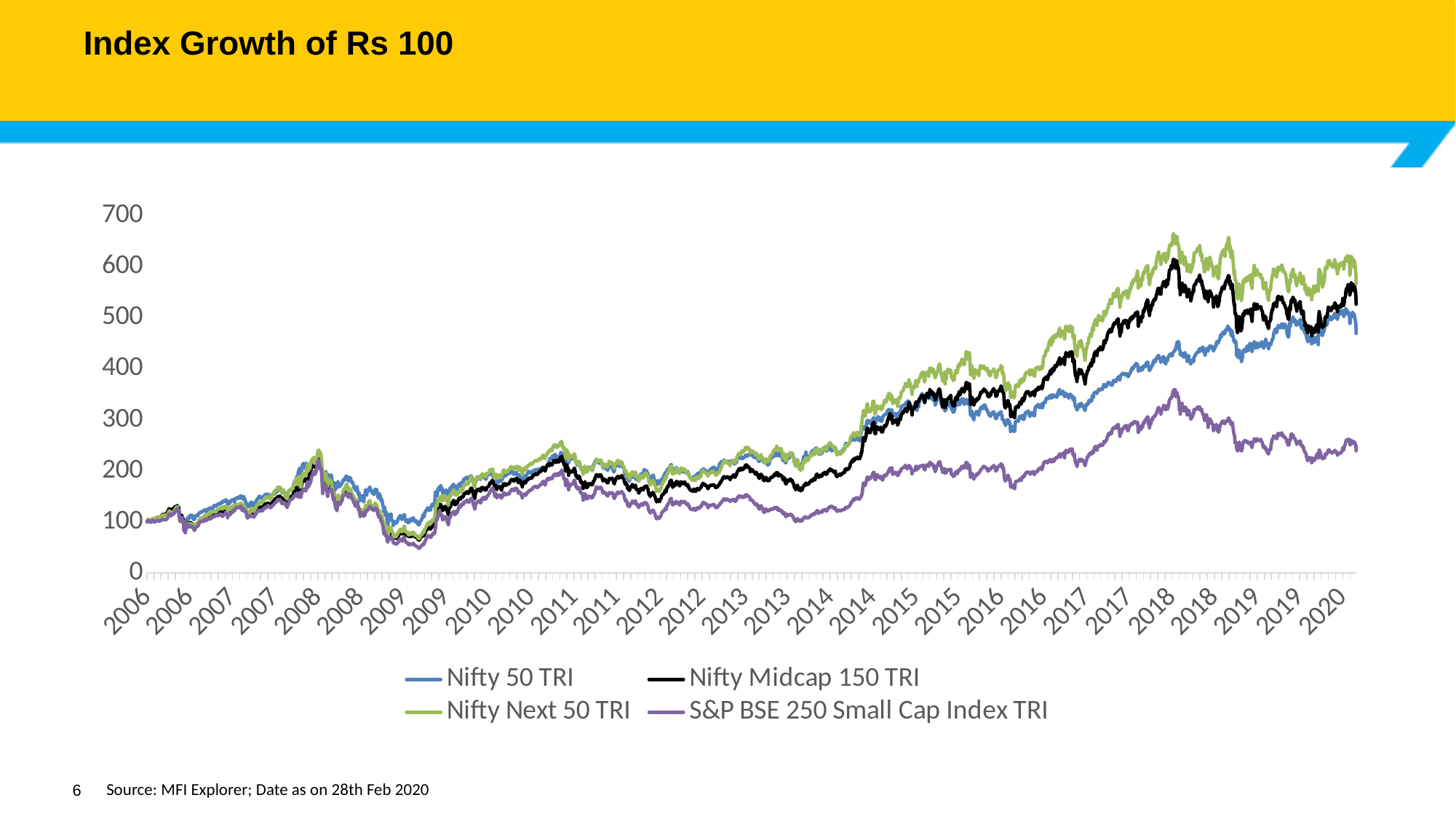
What kind of chart is shown on the slide? line chart At the end of the chart in 2020, which is larger: Nifty Next 50 TRI or S&P BSE 250 Small Cap Index TRI? Nifty Next 50 TRI Is the value of S&P BSE 250 Small Cap Index TRI at the end of 2020 greater or less than 300? less Is the lowest value of S&P BSE 250 Small Cap Index TRI in 2009 greater or less than 100? less Is the peak value of Nifty Next 50 TRI in 2018 greater or less than 600? greater What is the title of the chart? Index Growth of Rs 100 Which colour is used for the Nifty Midcap 150 TRI line? black Which series has the lowest value at the end of the chart in 2020? S&P BSE 250 Small Cap Index TRI How many series does the legend list? 4 Which series reaches the highest value anywhere on the chart? Nifty Next 50 TRI Overall, do the index values rise or fall from 2006 to 2020? rise At what value do all four series start in 2006? 100